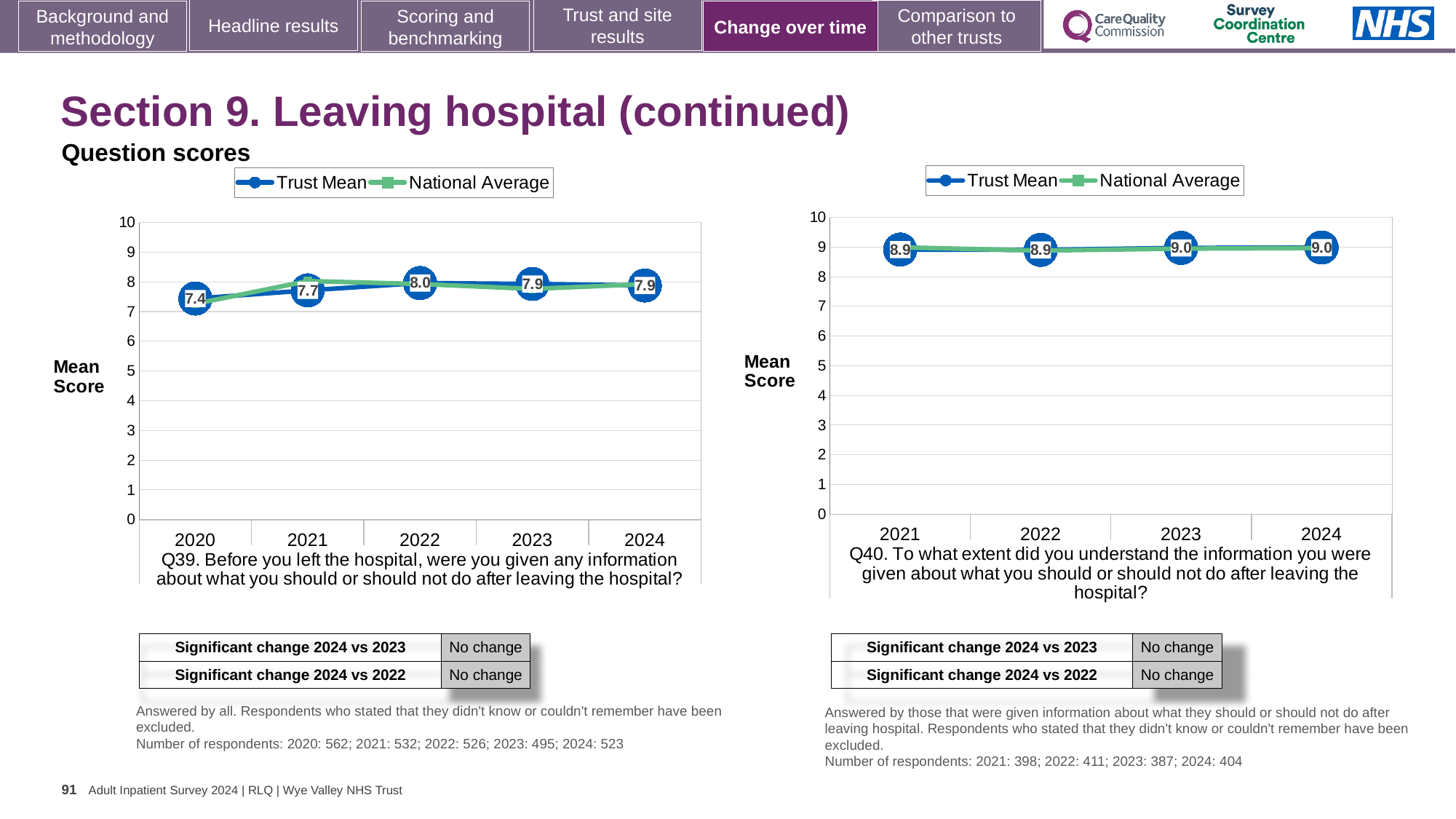
In the left chart (Q39), what is the difference between the Trust Mean scores for 2022 and 2020? 0.6 In the left chart (Q39), which year has the highest Trust Mean score? 2022 In the left chart (Q39), is the National Average value for 2021 greater or less than 7? greater How many series does the legend of the left chart (Q39) list? 2 In the left chart (Q39), what is the Trust Mean score for 2020? 7.4 How many years are plotted on the x axis of the right chart (Q40)? 4 In the left chart (Q39), which year has the lowest Trust Mean score? 2020 In the left chart (Q39), what is the Trust Mean score for 2022? 8.0 In the right chart (Q40), what is the Trust Mean score for 2024? 9.0 What type of chart is used for Q39 on the left? Line chart In the left chart (Q39), is the Trust Mean score higher in 2021 or in 2023? 2023 In the left chart (Q39), does the Trust Mean score rise or fall from 2020 to 2022? Rise